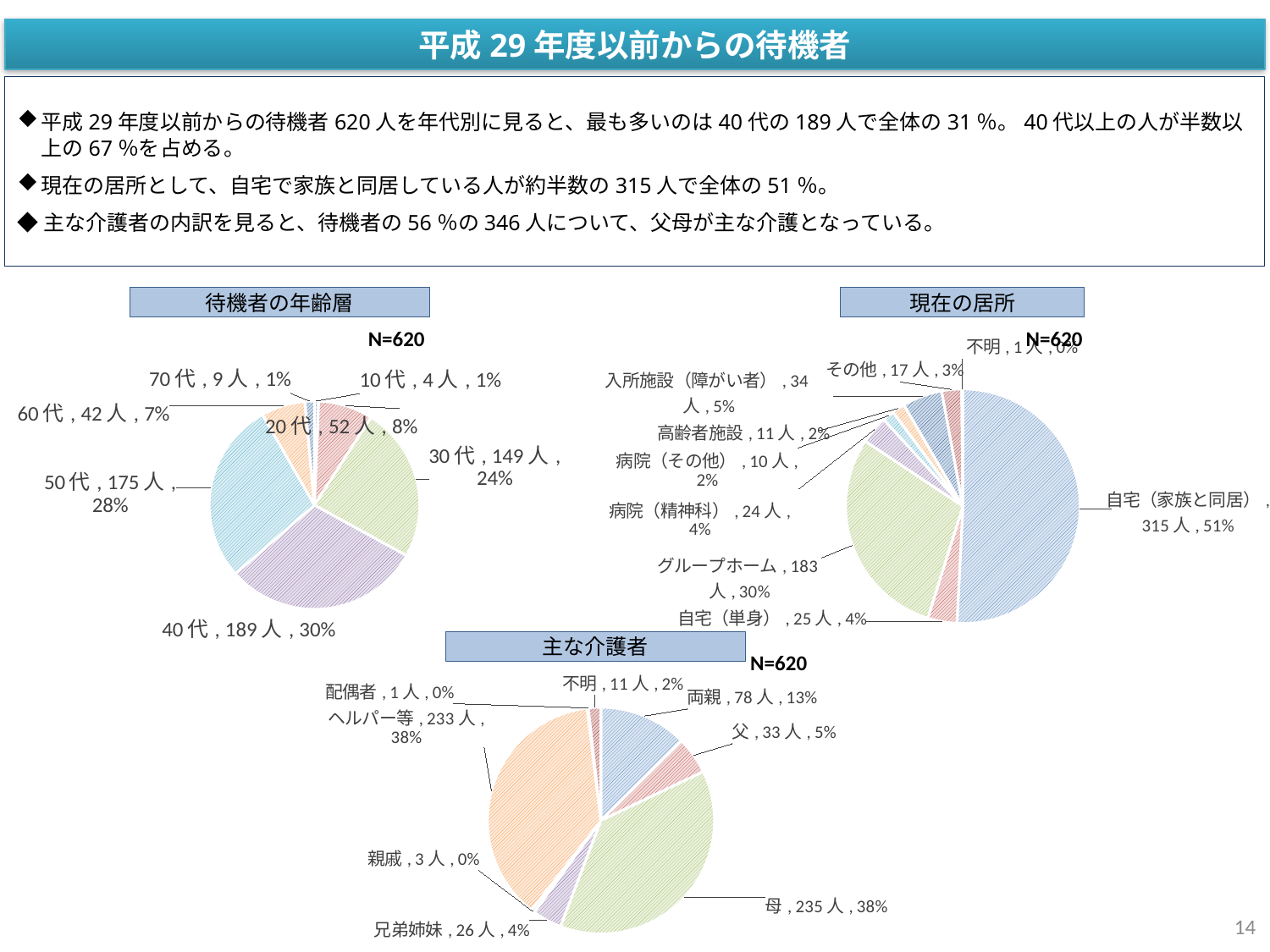
「現在の居所」の円グラフで、グループホームの割合は何%ですか？ 30% 「現在の居所」の円グラフで、病院（精神科）と病院（その他）ではどちらの人数が多いですか？ 病院（精神科） 「現在の居所」の円グラフで、最も人数が多い居所はどれですか？ 自宅（家族と同居） 「待機者の年齢層」の円グラフには、いくつの年代区分がありますか？ 7 「待機者の年齢層」の円グラフで、最も人数が多い年代はどれですか？ 40代 「主な介護者」の円グラフで、両親の人数は何人ですか？ 78人 「待機者の年齢層」の円グラフで、最も人数が少ない年代はどれですか？ 10代 「待機者の年齢層」の円グラフで、50代と30代の人数の差は何人ですか？ 26人 「主な介護者」の円グラフで、最も人数が少ない区分はどれですか？ 配偶者 このスライドの3つのグラフはどの種類のグラフですか？ 円グラフ 「待機者の年齢層」の円グラフで、40代の人数は何人ですか？ 189人 「現在の居所」の円グラフには、いくつの区分がありますか？ 9